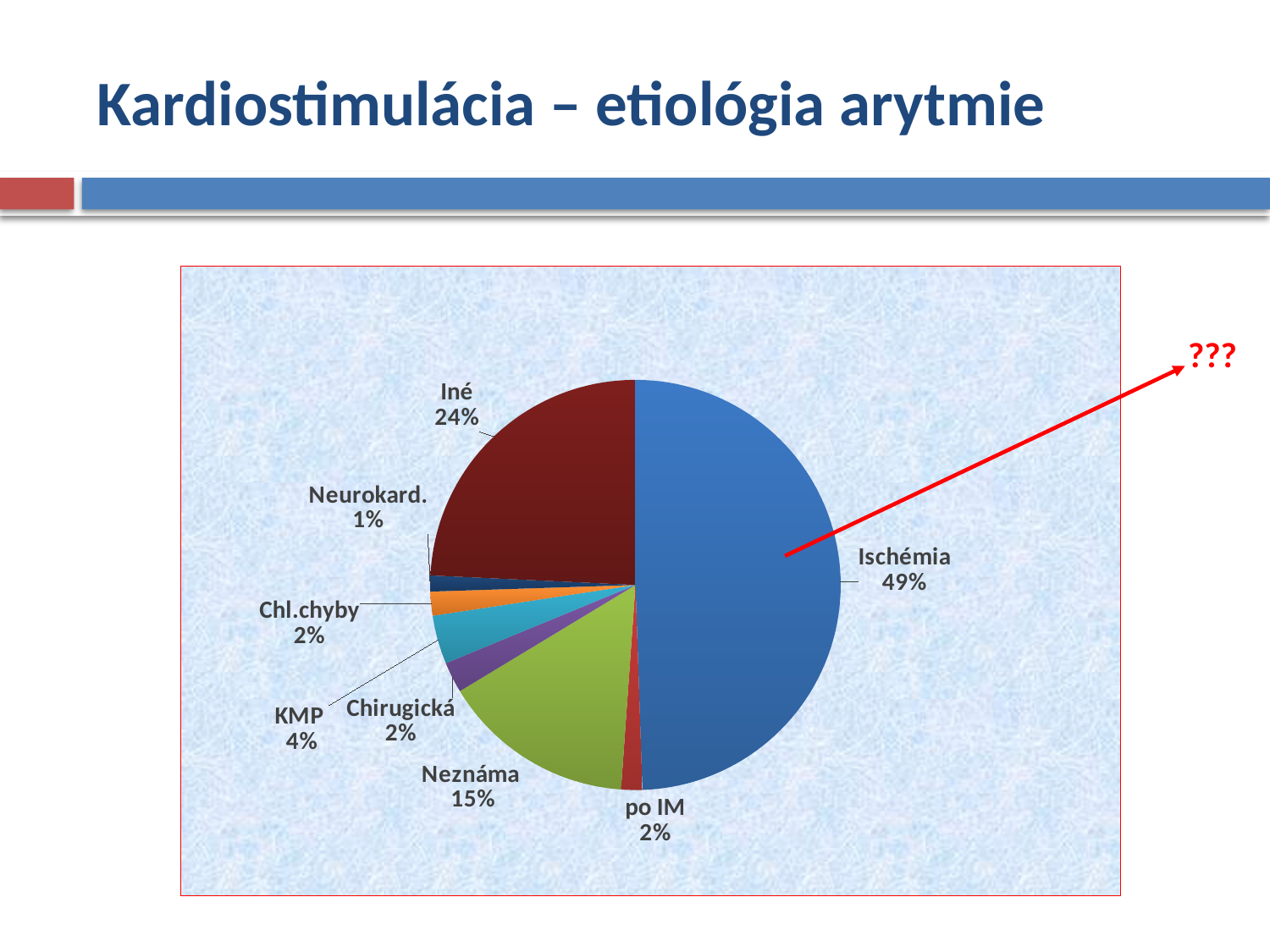
What percentage is shown for KMP? 4% What is the difference in percentage points between Ischémia and Iné? 25 Which is larger, the share for Neznáma or the share for KMP? Neznáma What percentage is shown for Neurokard.? 1% What percentage is shown for Iné? 24% What is the title of the slide containing the chart? Kardiostimulácia – etiológia arytmie Which category has the smallest slice of the pie? Neurokard. How many categories are shown in the pie chart? 8 What percentage is shown for Neznáma? 15% Which category has the largest slice of the pie? Ischémia What share of the pie does Ischémia represent? 49% What kind of chart is shown on the slide? Pie chart